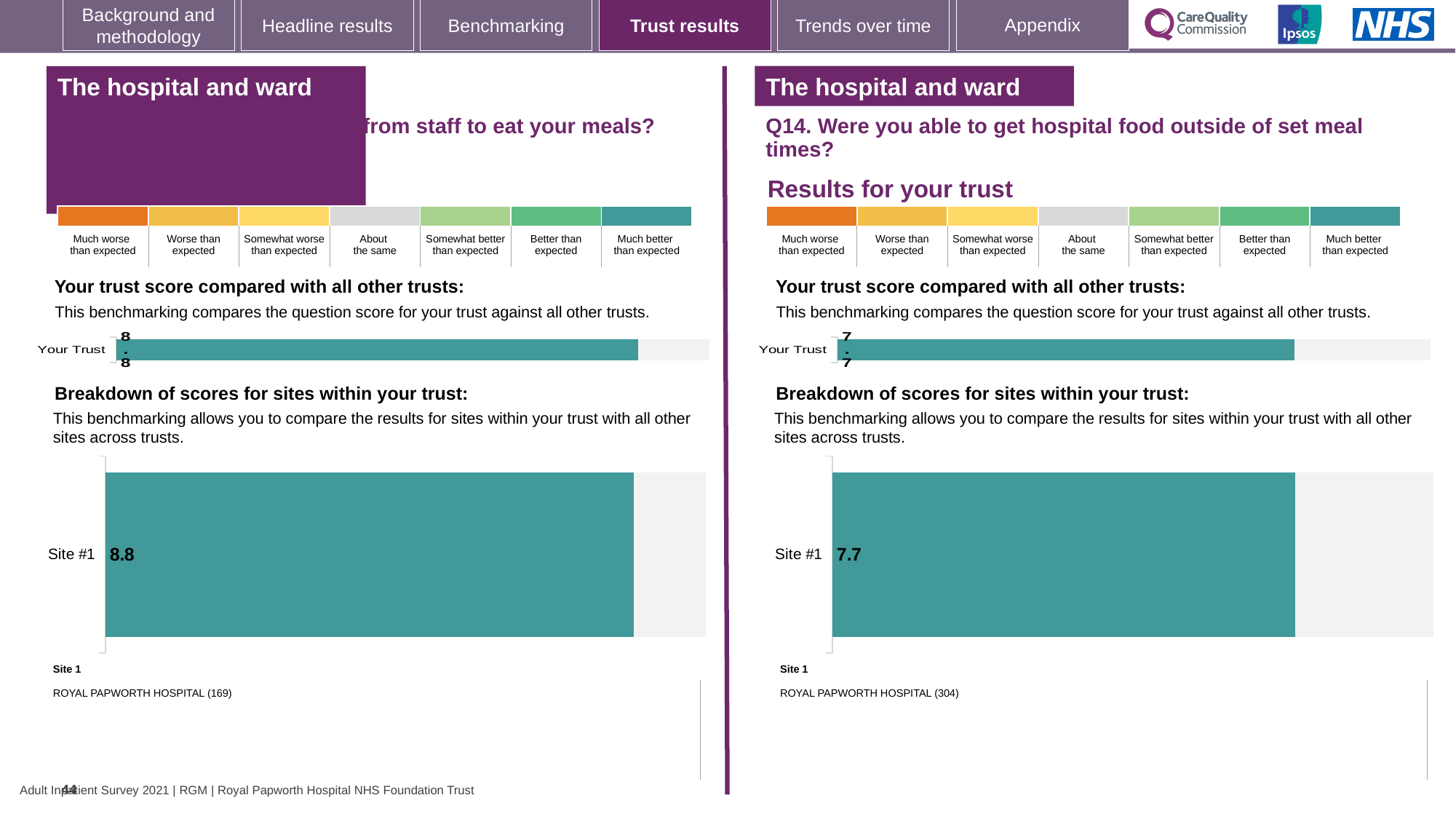
What colour are the score bars in the charts on this slide? Teal How many sites are shown in the 'Breakdown of scores for sites within your trust' chart on the left-hand side of the slide? 1 On the right-hand side of the slide (Q14), what score is shown for Site #1 in the 'Breakdown of scores for sites within your trust' chart? 7.7 What is the difference between the Your Trust score on the left-hand side of the slide and the Your Trust score on the right-hand side (Q14)? 1.1 On the left-hand side of the slide, what score is shown for Site #1 in the 'Breakdown of scores for sites within your trust' chart? 8.8 How many sites are shown in the 'Breakdown of scores for sites within your trust' chart on the right-hand side of the slide (Q14)? 1 What type of chart is used to show the Site #1 score on the right-hand side of the slide (Q14)? Bar chart Which is larger: the Site #1 score on the left-hand side of the slide or the Site #1 score on the right-hand side (Q14)? Left-hand side (8.8) On the right-hand side of the slide (Q14), what is the score shown for Your Trust in the 'Your trust score compared with all other trusts' chart? 7.7 On the left-hand side of the slide, what is the score shown for Your Trust in the 'Your trust score compared with all other trusts' chart? 8.8 Which site name is listed as Site 1 below the right-hand chart (Q14)? ROYAL PAPWORTH HOSPITAL (304) On the right-hand side of the slide, is the Site #1 score equal to the Your Trust score? Yes